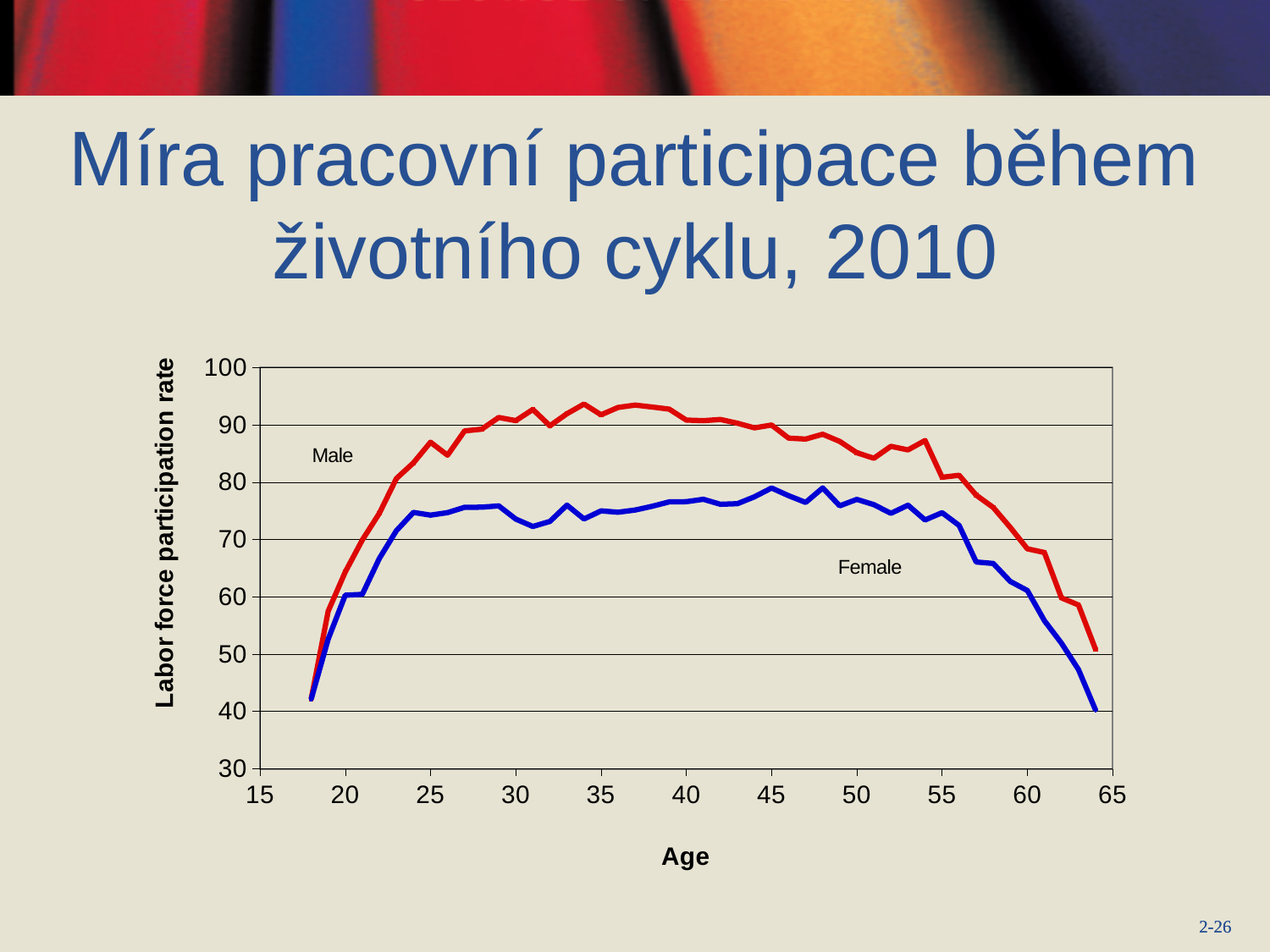
What kind of chart is shown on the slide? Line chart What is the label of the vertical axis? Labor force participation rate At age 40, which series has the higher participation rate, Male or Female? Male Is the Male value at age 60 greater or less than 70? less Which series is plotted in red? Male How many series are plotted on the chart? 2 Is the Female value at age 30 greater or less than 70? greater Does the Male participation rate rise or fall between age 18 and age 25? Rise Is the Male value at age 25 greater or less than 80? greater Does the Female participation rate rise or fall between age 55 and age 64? Fall